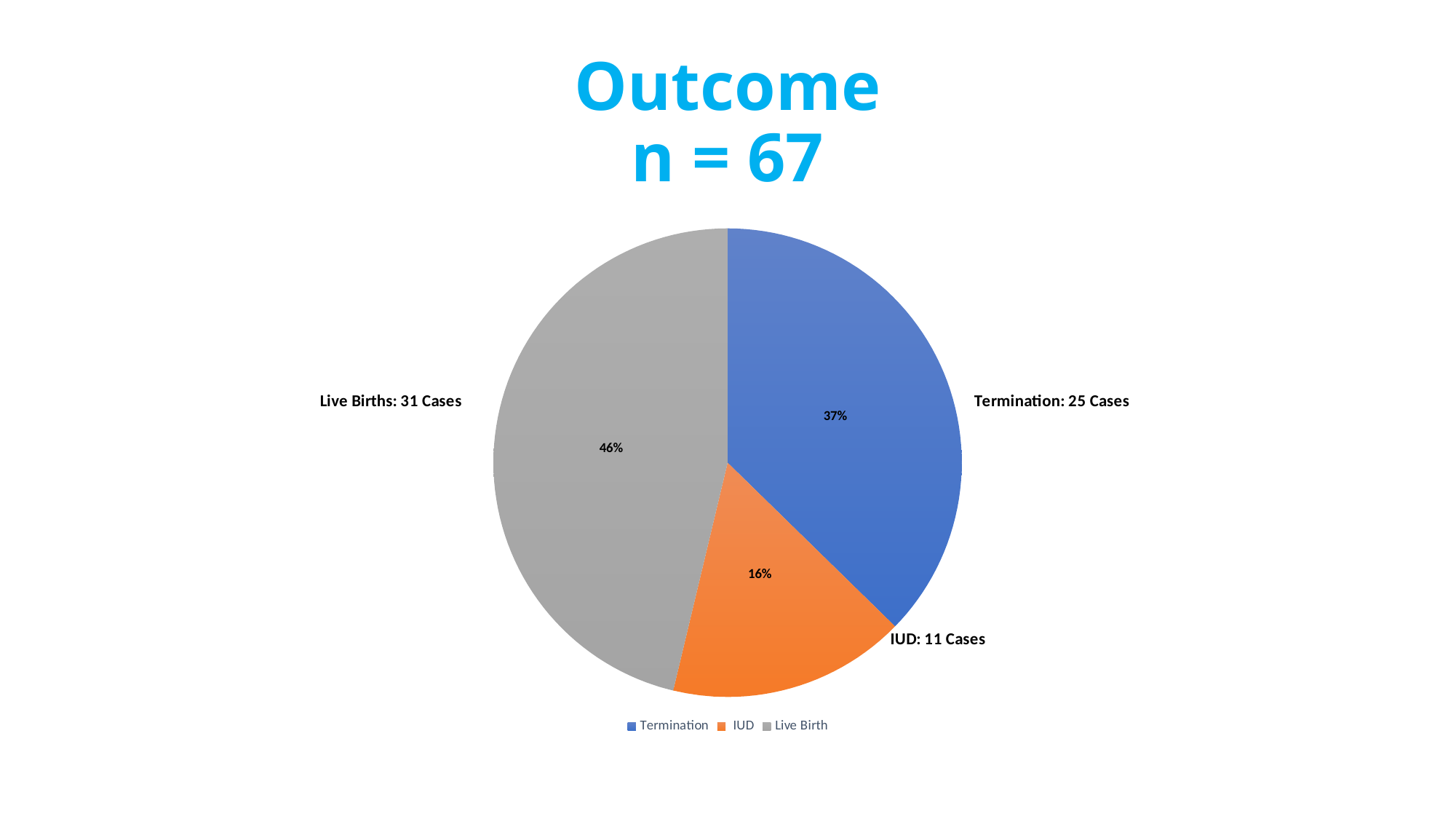
Which has more cases, Termination or IUD? Termination What percentage of the pie does the Termination slice represent? 37% How many cases are labelled for Termination? 25 Cases How many entries does the legend list? 3 What kind of chart is shown on the slide? pie chart What is the difference in cases between Live Births and Termination? 6 Which outcome has the largest slice of the pie? Live Birth What percentage of the pie does the IUD slice represent? 16% What percentage of the pie does the Live Birth slice represent? 46% How many cases are labelled for IUD? 11 Cases How many cases are labelled for Live Births? 31 Cases Which outcome has the smallest slice of the pie? IUD